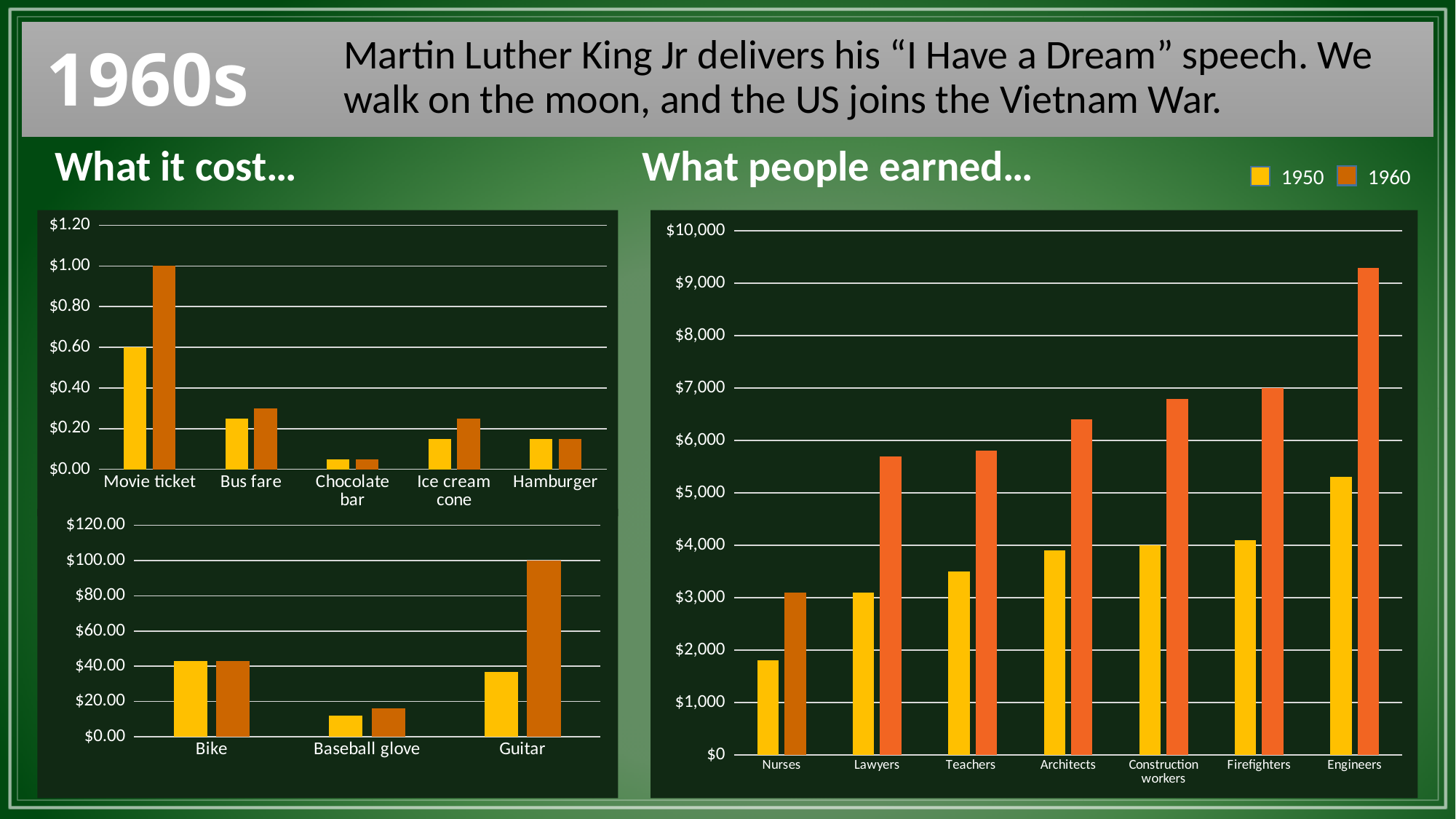
On the 'What people earned...' chart, what did Firefighters earn in 1960? $7,000 On the top-left 'What it cost...' chart, what was the 1960 price of a movie ticket? $1.00 On the 'What people earned...' chart, do the 1960 values rise or fall moving from Nurses to Engineers along the x axis? rise How many series does the legend list for the 'What people earned...' chart? 2 On the 'What people earned...' chart, is the 1950 value for Nurses greater or less than $2,000? less How many occupations are shown on the 'What people earned...' chart? 7 What kind of chart is the 'What people earned...' chart on the right? bar chart On the 'What people earned...' chart, is the 1960 value for Engineers greater or less than $9,000? greater On the 'What people earned...' chart, which occupation has the lowest 1950 earnings? Nurses On the 'What people earned...' chart, which occupation has the highest 1960 earnings? Engineers On the top-left 'What it cost...' chart, what was the 1950 price of a movie ticket? $0.60